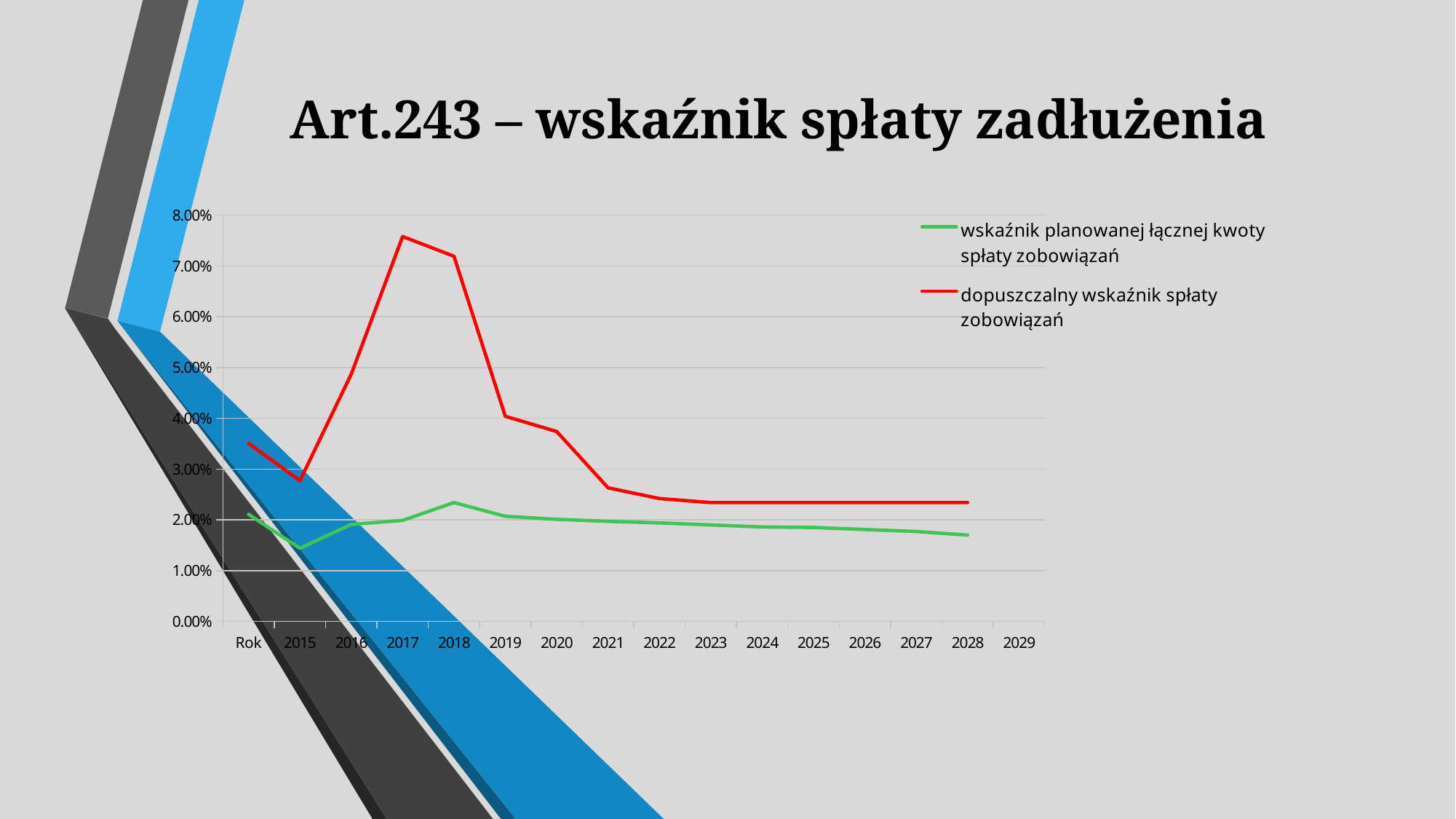
In 2017, which series has the larger value: 'dopuszczalny wskaźnik spłaty zobowiązań' or 'wskaźnik planowanej łącznej kwoty spłaty zobowiązań'? dopuszczalny wskaźnik spłaty zobowiązań Is the value of 'dopuszczalny wskaźnik spłaty zobowiązań' in 2020 greater or less than 4.00%? less Does the red line 'dopuszczalny wskaźnik spłaty zobowiązań' rise or fall between 2018 and 2023? fall What is the title of the chart slide? Art.243 – wskaźnik spłaty zadłużenia Which colour is used for the series 'dopuszczalny wskaźnik spłaty zobowiązań'? red Is the value of 'dopuszczalny wskaźnik spłaty zobowiązań' in 2028 greater or less than 2.00%? greater In which year does the red line 'dopuszczalny wskaźnik spłaty zobowiązań' reach its highest value? 2017 Is the value of 'wskaźnik planowanej łącznej kwoty spłaty zobowiązań' in 2015 greater or less than 2.00%? less In which year does the green line 'wskaźnik planowanej łącznej kwoty spłaty zobowiązań' reach its lowest value? 2015 What kind of chart is shown on the slide? line chart How many series does the legend list? 2